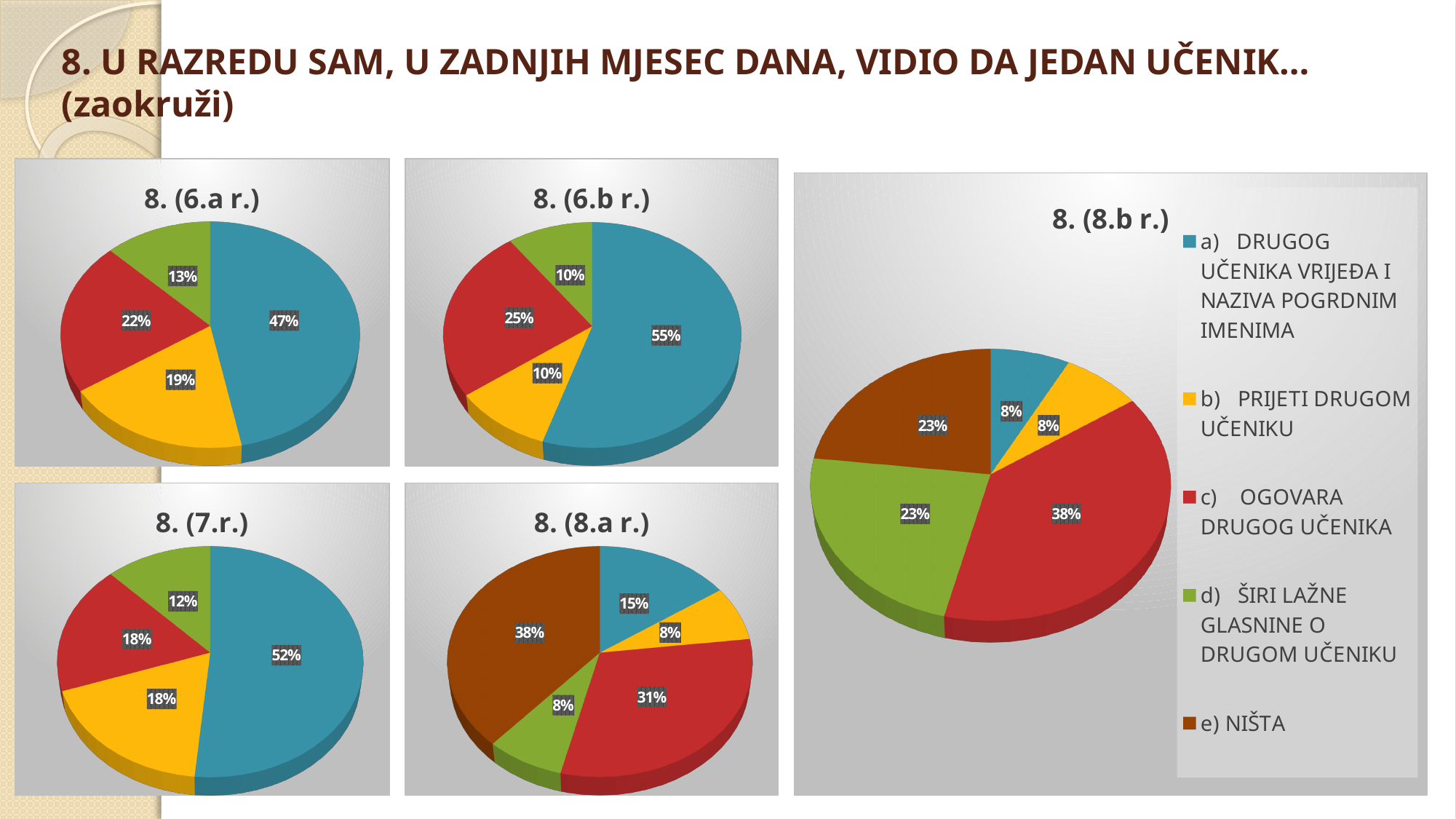
What type of chart is the chart titled "8. (7.r.)"? pie chart How many entries does the legend next to the chart titled "8. (8.b r.)" list? 5 In the chart titled "8. (6.a r.)", what percentage is shown on the blue slice? 47% In the chart titled "8. (7.r.)", what percentage is shown on the green slice? 12% In the chart titled "8. (8.b r.)", what percentage is shown for "c) OGOVARA DRUGOG UČENIKA"? 38% In the chart titled "8. (8.a r.)", what percentage is shown on the brown slice? 38% In the chart titled "8. (8.b r.)", what percentage is shown for "e) NIŠTA"? 23% In the chart titled "8. (6.b r.)", which is larger: the red slice or the yellow slice? the red slice In the chart titled "8. (8.b r.)", which category has the largest slice? c) OGOVARA DRUGOG UČENIKA In the chart titled "8. (6.b r.)", what is the largest percentage shown? 55% In the chart titled "8. (8.a r.)", what is the difference between the brown slice (38%) and the red slice (31%)? 7% How many slices does the chart titled "8. (8.a r.)" have? 5